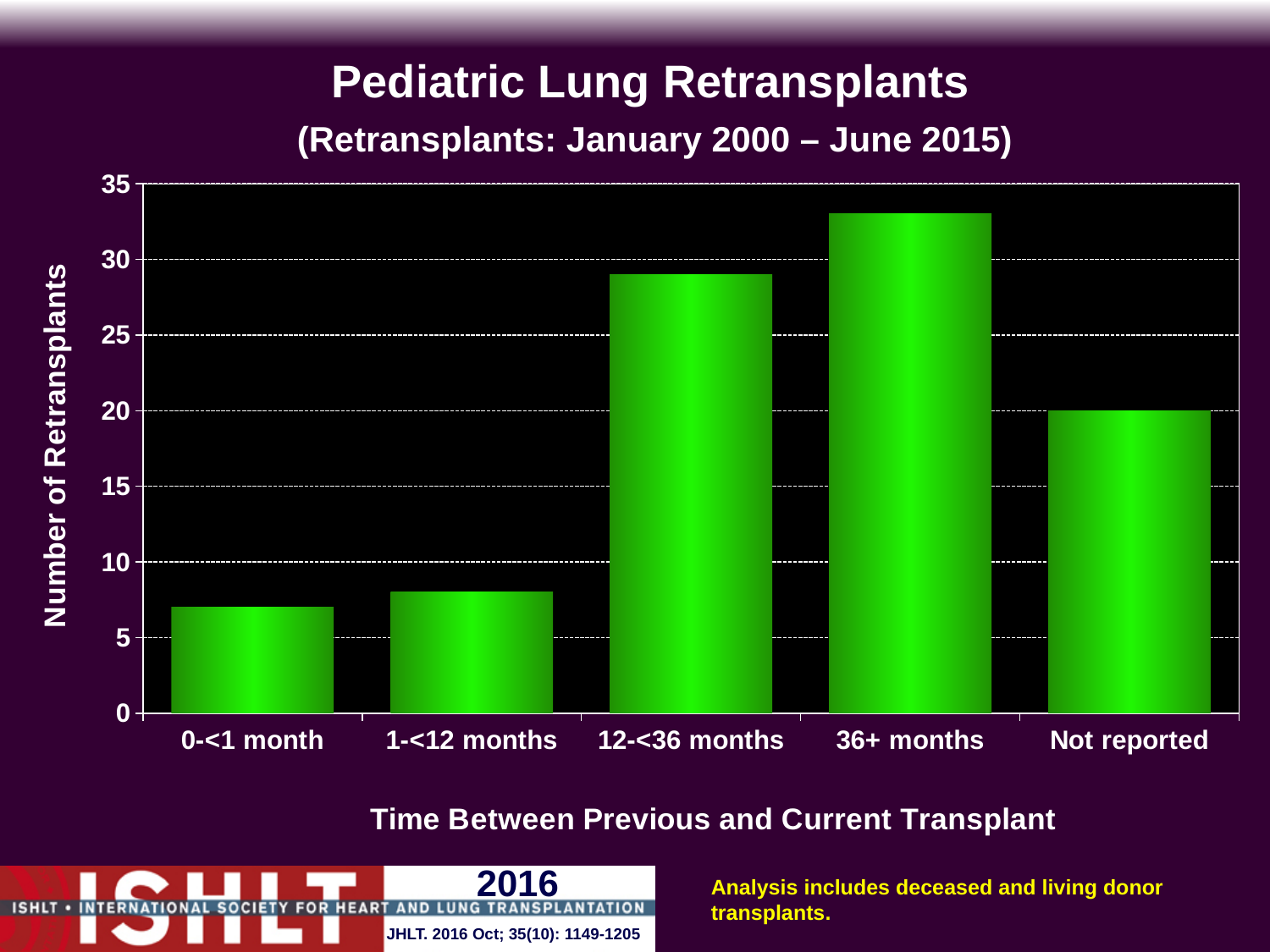
What is the title of the chart? Pediatric Lung Retransplants Which has more retransplants: '0-<1 month' or 'Not reported'? Not reported Is the number of retransplants for '0-<1 month' greater or less than 10? less Which time-between-transplants category has the highest number of retransplants? 36+ months Which has more retransplants: '12-<36 months' or '36+ months'? 36+ months How many categories are shown on the x axis of the chart? 5 Is the number of retransplants for '1-<12 months' greater or less than 10? less What is the label of the y axis? Number of Retransplants What kind of chart is shown on the slide? bar chart Is the number of retransplants for '36+ months' greater or less than 30? greater What is the number of retransplants for the 'Not reported' category? 20